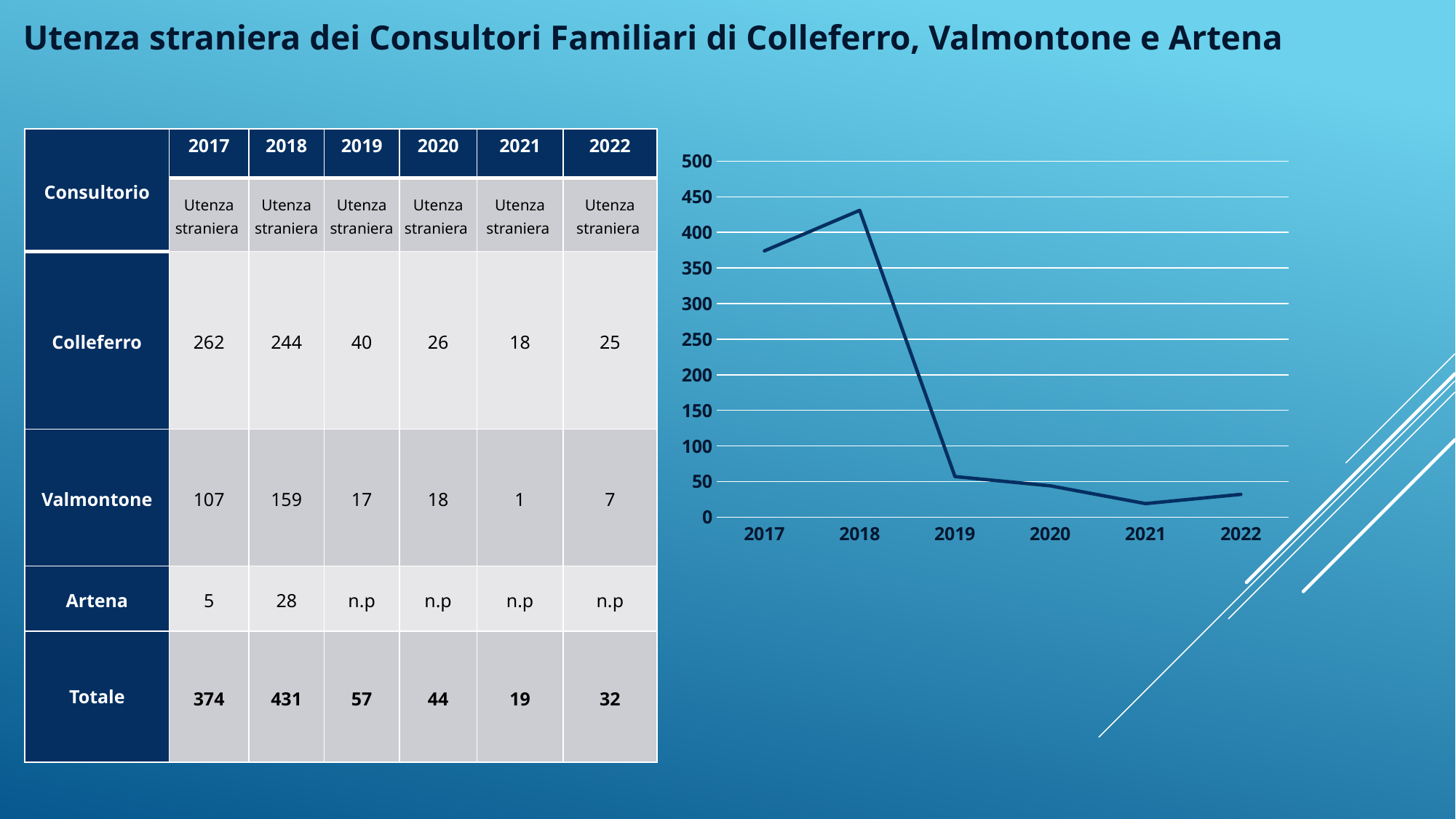
On the line chart, which year has the larger value, 2021 or 2022? 2022 How many data points are plotted on the line chart? 6 Is the value for 2021 on the line chart greater or less than 50? less What kind of chart is shown on the right of the slide? line chart Is the value for 2018 on the line chart greater or less than 400? greater Does the line chart rise or fall overall from 2017 to 2022? fall Is the value for 2017 on the line chart greater or less than 350? greater In which year does the line chart reach its lowest value? 2021 In which year does the line chart reach its highest value? 2018 What is the highest value shown on the y axis of the line chart? 500 On the line chart, which year has the larger value, 2017 or 2018? 2018